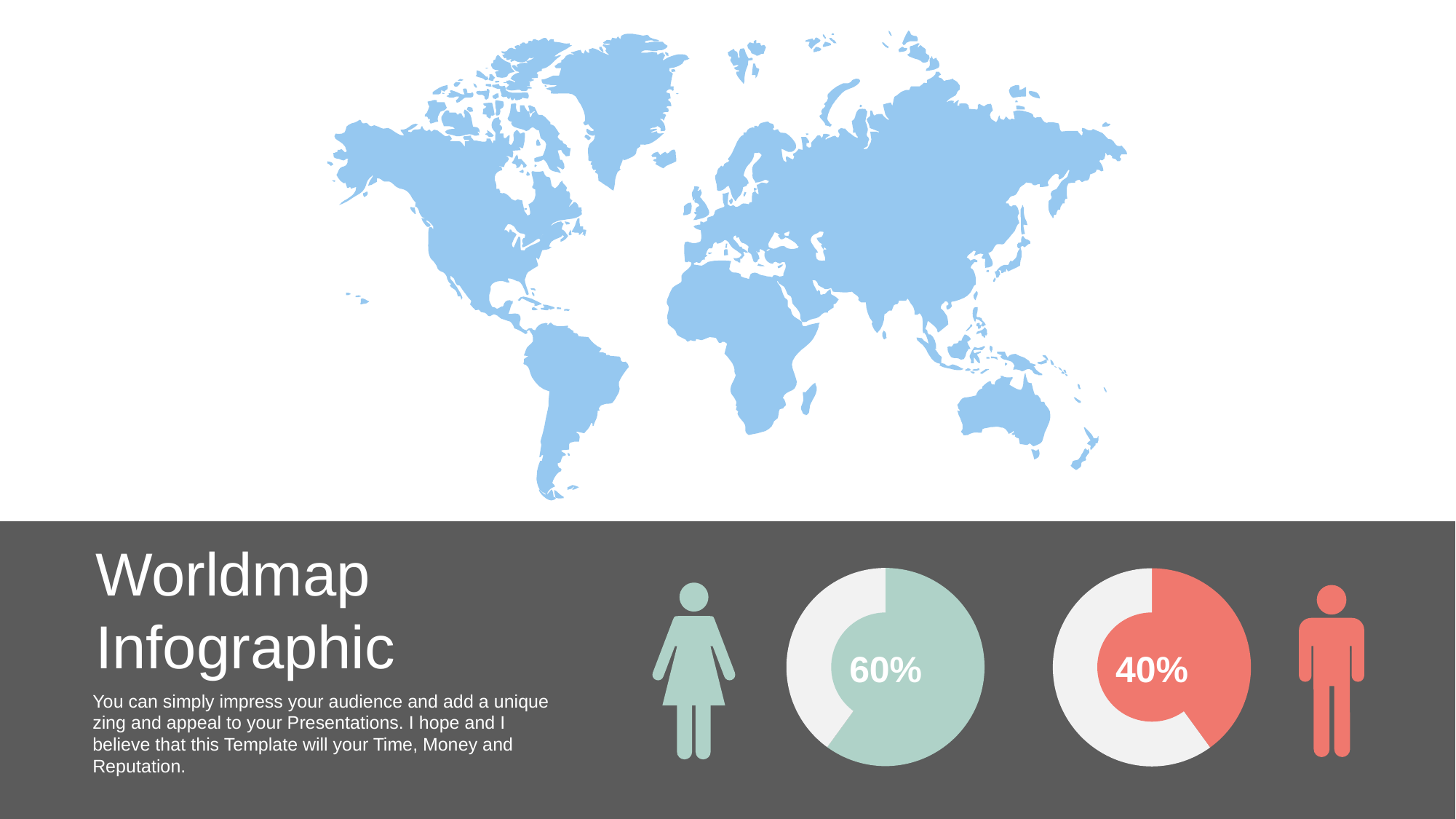
Is the value shown in the right pie chart (male figure) greater or less than 50%? less Which pie chart shows the larger percentage, the left one (female figure) or the right one (male figure)? the left one (female figure) What is the difference between the percentage in the left pie chart and the percentage in the right pie chart? 20% What kind of chart is used to display the 60% and 40% values on the slide? pie chart What percentage is shown in the left pie chart, next to the female figure? 60% What colour is the filled portion of the right pie chart showing 40%? red What percentage is shown in the right pie chart, next to the male figure? 40% Is the value shown in the left pie chart (female figure) greater or less than 50%? greater What colour is the filled portion of the left pie chart showing 60%? green How many pie charts are shown on the slide? 2